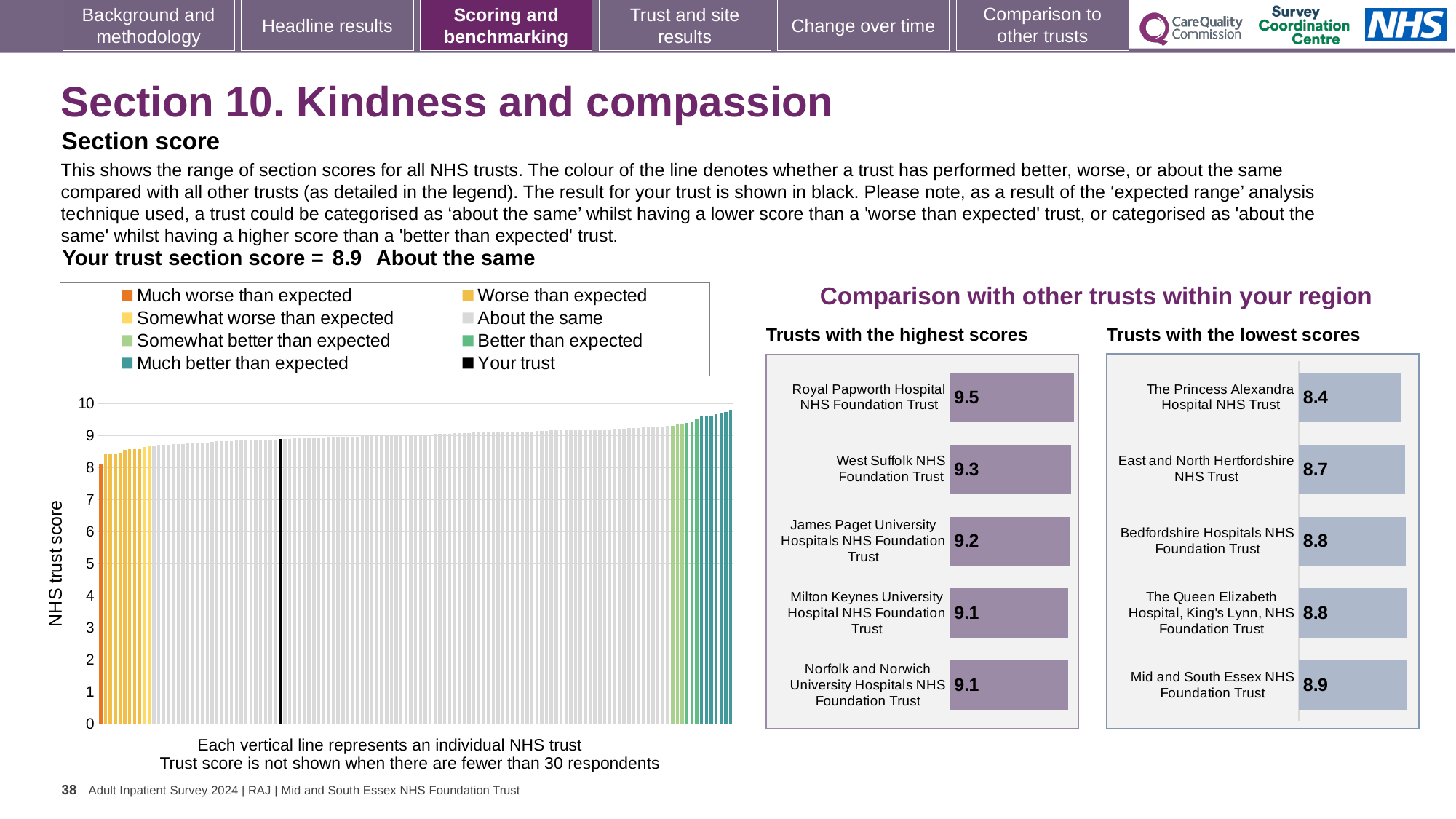
How many entries does the legend of the NHS trust score chart on the left list? 8 In the 'Trusts with the highest scores' chart, which trust has the highest score? Royal Papworth Hospital NHS Foundation Trust What is the section score for your trust shown on the slide? 8.9 In the 'Trusts with the highest scores' chart, what is the difference between the scores of Royal Papworth Hospital NHS Foundation Trust and West Suffolk NHS Foundation Trust? 0.2 In the 'Trusts with the lowest scores' chart, what is the difference between the scores of Mid and South Essex NHS Foundation Trust and The Princess Alexandra Hospital NHS Trust? 0.5 In the NHS trust score chart on the left, do the values rise or fall from left to right along the x axis? Rise In the 'Trusts with the lowest scores' chart, what is the score for The Princess Alexandra Hospital NHS Trust? 8.4 In the 'Trusts with the highest scores' chart, what is the score for Royal Papworth Hospital NHS Foundation Trust? 9.5 How many trusts are listed in the 'Trusts with the highest scores' chart? 5 What kind of chart is the NHS trust score chart on the left of the slide? Bar chart In the 'Trusts with the lowest scores' chart, which trust has the lowest score? The Princess Alexandra Hospital NHS Trust In the 'Trusts with the highest scores' chart, which has the higher score: James Paget University Hospitals NHS Foundation Trust or Milton Keynes University Hospital NHS Foundation Trust? James Paget University Hospitals NHS Foundation Trust